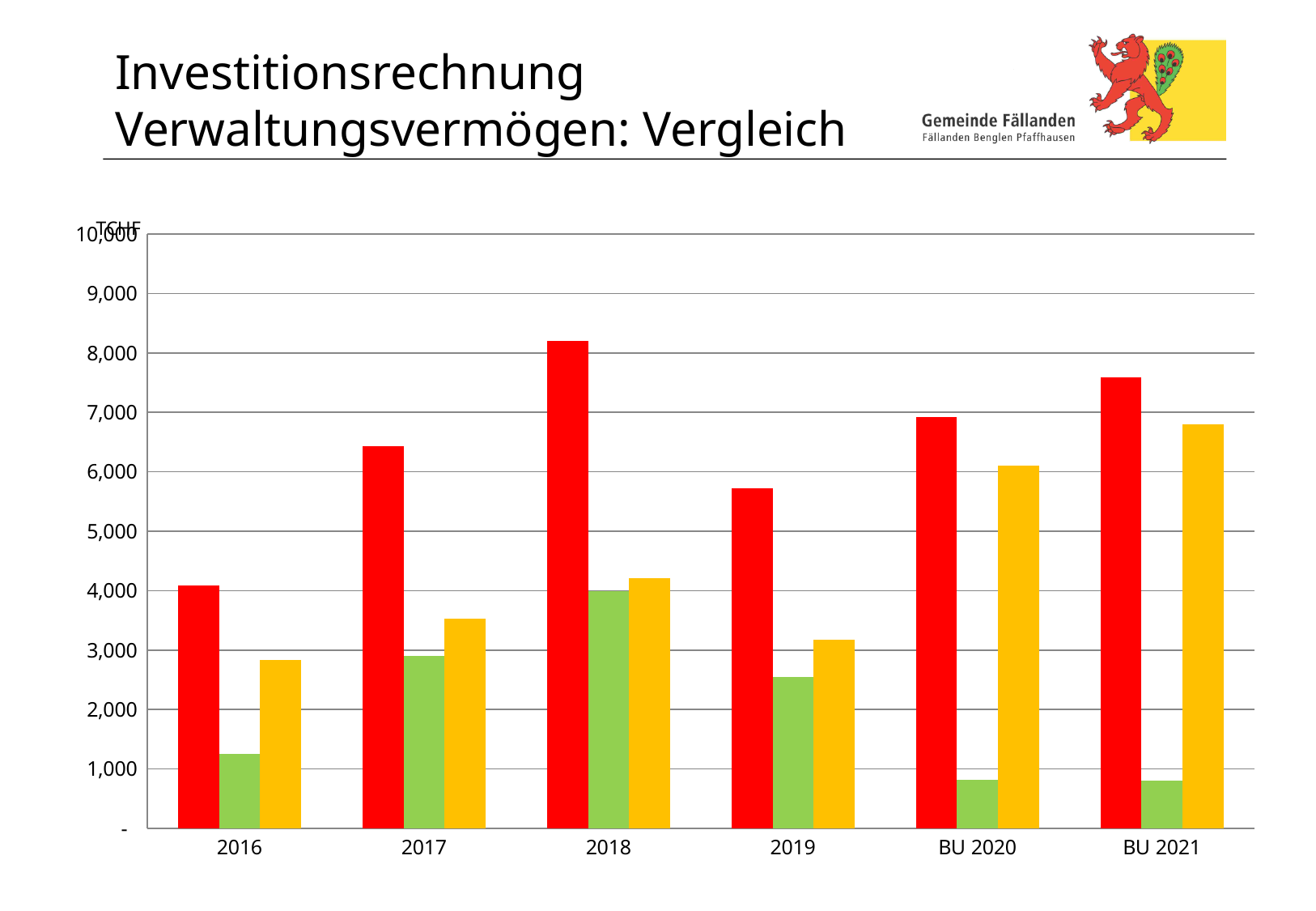
In which category is the yellow bar the highest? BU 2021 In which category is the green bar the highest? 2018 Is the value of the green bar for BU 2020 greater or less than 1,000? less In which category is the red bar the lowest? 2016 Is the value of the yellow bar for BU 2021 greater or less than 6,000? greater For BU 2020, which bar is larger, the yellow bar or the green bar? the yellow bar How many bars are shown for each year category? 3 What kind of chart is shown on the slide? bar chart Is the value of the red bar for 2018 greater or less than 8,000? greater In which category is the red bar the highest? 2018 What unit label is shown at the top of the vertical axis? TCHF How many categories are shown along the x axis? 6